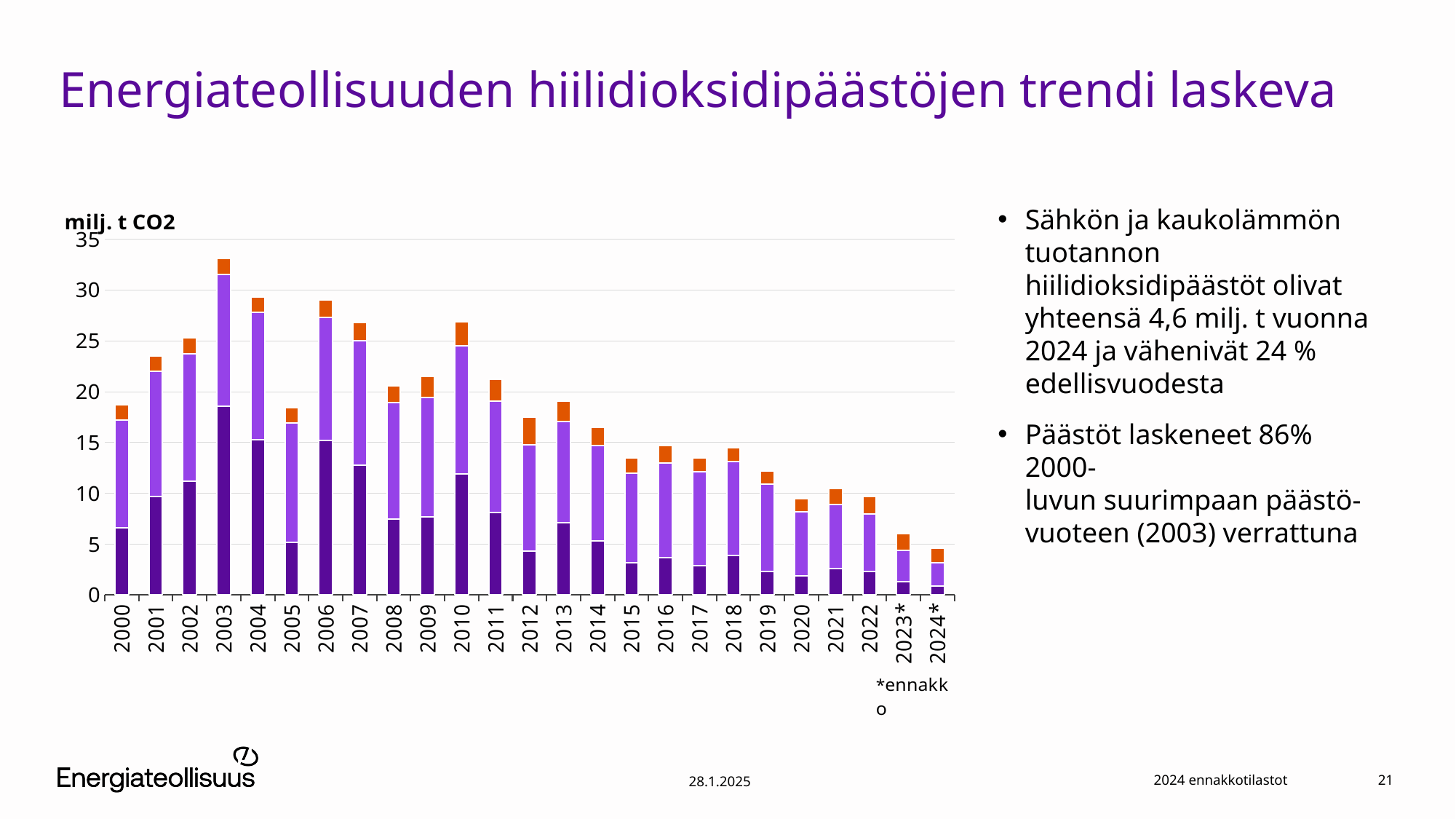
Is the total value for 2024* greater or less than 5? less What unit label is shown above the y axis of the chart? milj. t CO2 How many years are shown on the x axis of the chart? 25 What kind of chart is shown on the slide? bar chart Do the total emissions generally rise or fall from 2003 to 2024*? fall Which year has the lowest total emissions in the chart? 2024* Which year has a higher total, 2003 or 2004? 2003 Is the total value for 2010 greater or less than 25? greater Which year has a higher total, 2010 or 2011? 2010 Which year has the highest total emissions in the chart? 2003 Is the total value for 2003 greater or less than 30? greater